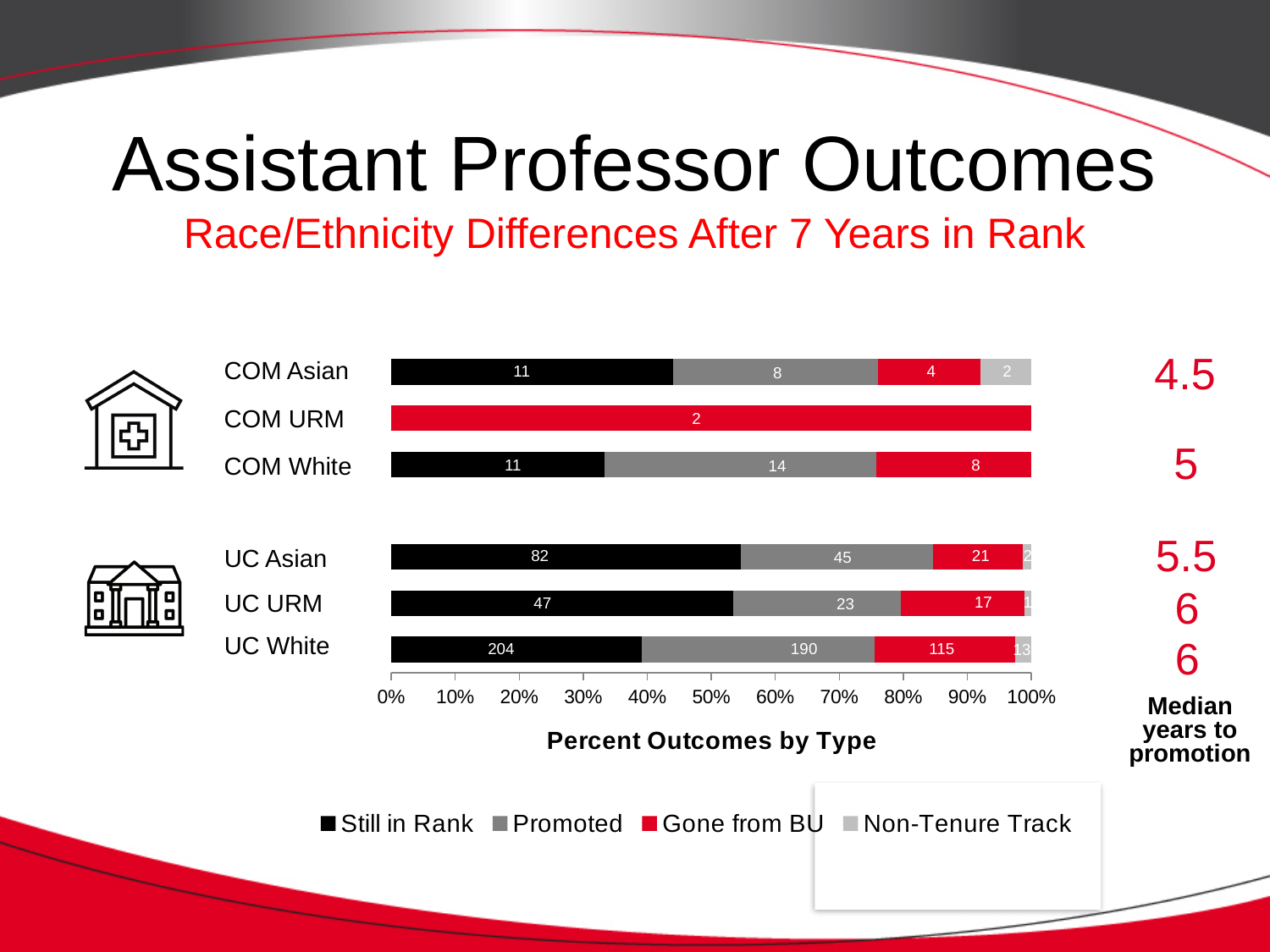
Which category has the highest Still in Rank value? UC White What is the difference between the Promoted values for UC White and UC Asian? 14 What is the total of all labelled values in the UC URM bar? 88 How many series does the legend list? 4 What type of chart is shown on the slide? Bar chart What is the Promoted value for COM White? 14 How many categories are plotted on the chart? 6 What is the total of all labelled values in the COM Asian bar? 25 How many data labels are shown for the Still in Rank series for UC White? 1 Which is larger, the Gone from BU value for UC URM or for COM White? UC URM What is the Gone from BU value for UC Asian? 21 What is the Non-Tenure Track value for UC White? 13